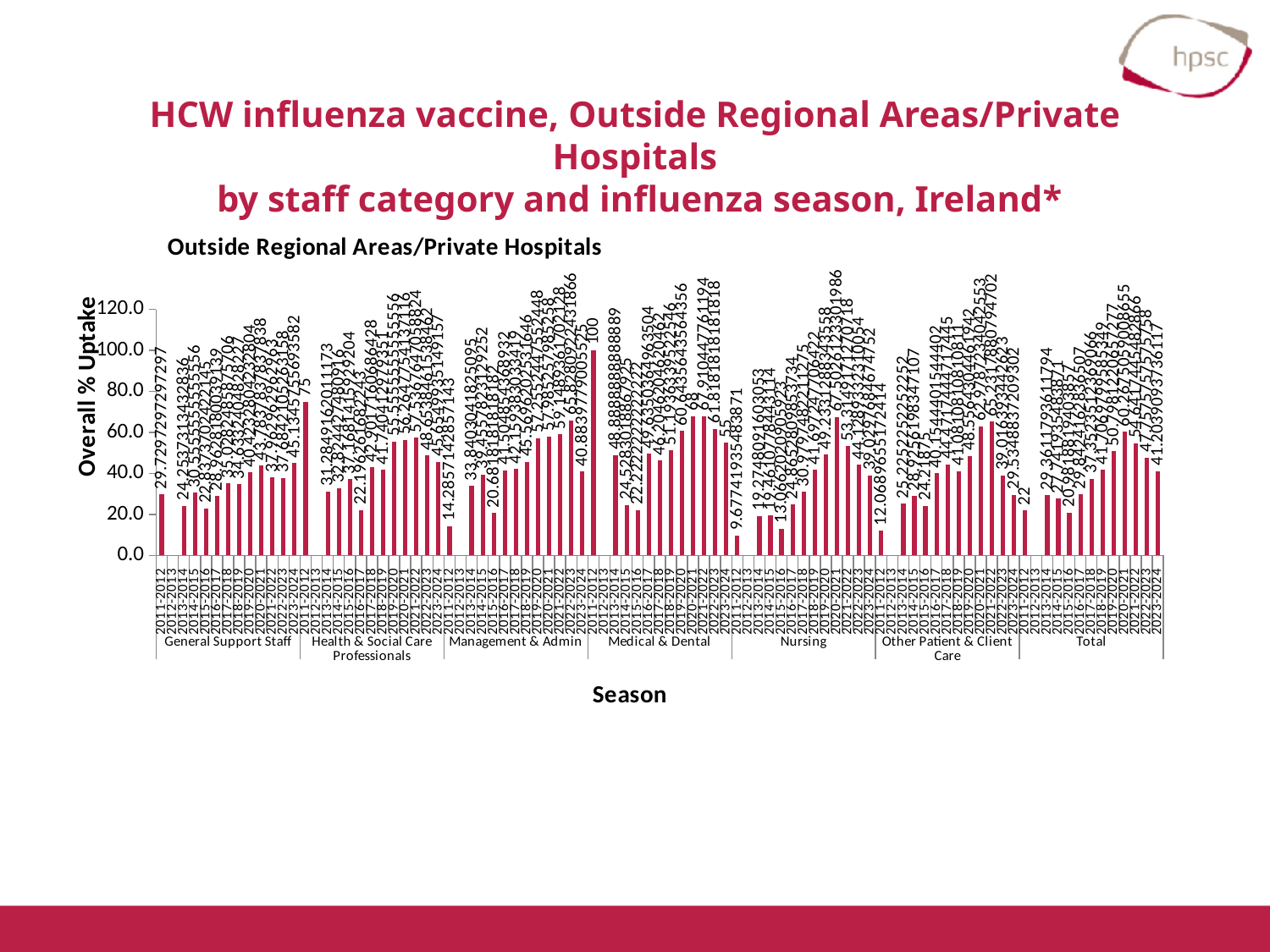
What is the label on the y axis of the chart? Overall % Uptake Which staff category and season has the highest overall % uptake in the chart? Medical & Dental, 2011-2012 How many staff categories are shown along the x axis of the chart? 7 What type of chart is shown on the slide? bar chart What is the overall % uptake for General Support Staff in the 2023-2024 season? 45.1 What is the overall % uptake for Management & Admin in the 2023-2024 season? 40.8839779005525 How many influenza seasons are plotted for each staff category? 13 Which staff category and season has the lowest overall % uptake in the chart? Nursing, 2011-2012 What is the overall % uptake for Other Patient & Client Care in the 2023-2024 season? 29.5348837209302 Which is larger in the 2023-2024 season: the uptake for General Support Staff or for Management & Admin? General Support Staff Is the overall % uptake for Management & Admin in 2011-2012 greater or less than 20.0? less